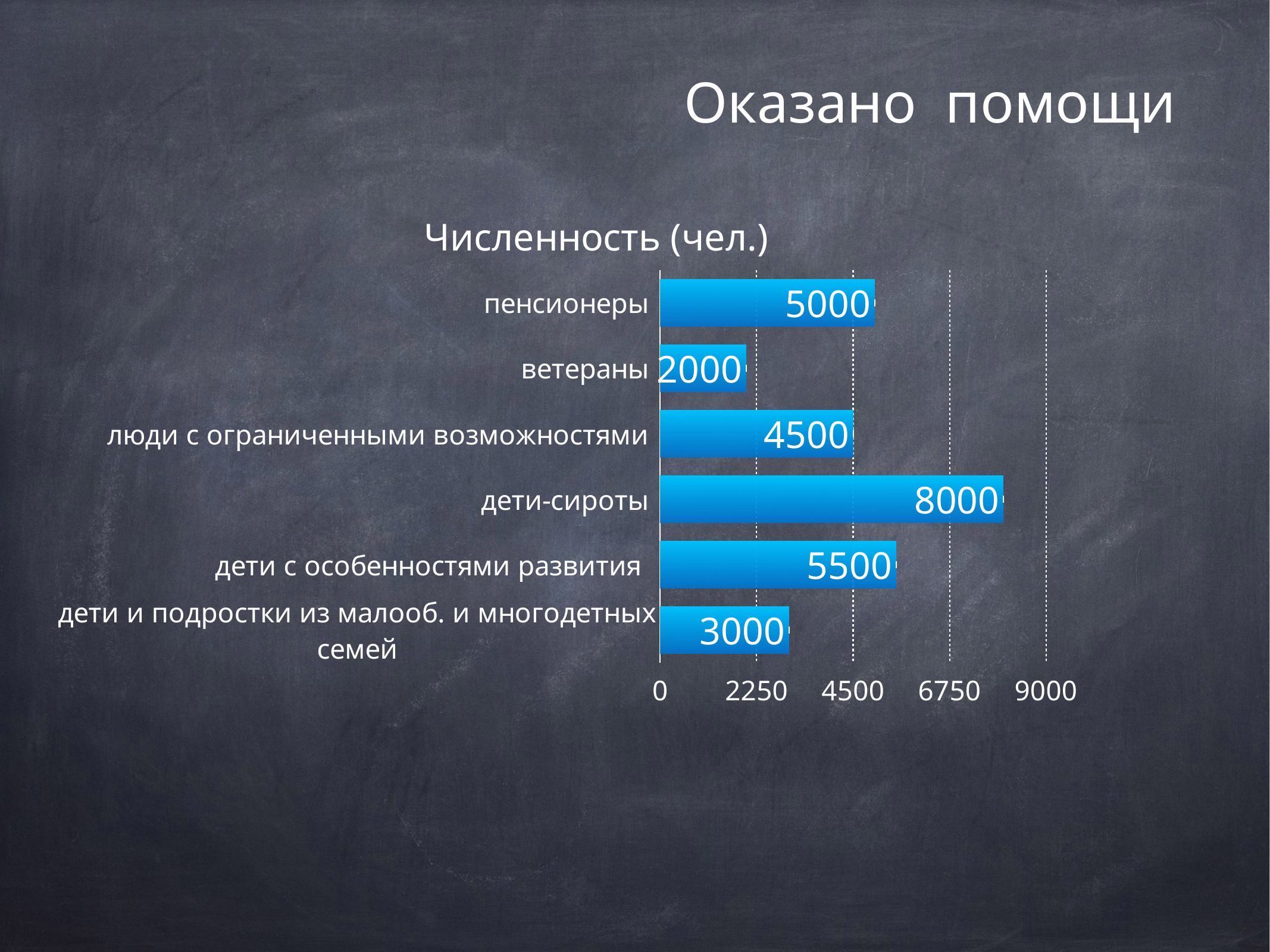
What is the value for дети-сироты? 8000 Is the value for дети и подростки из малооб. и многодетных семей greater or less than 4500? less What is the value for дети с особенностями развития? 5500 How many categories are shown in the chart? 6 Which is larger, the value for люди с ограниченными возможностями or the value for дети с особенностями развития? дети с особенностями развития What is the value for пенсионеры? 5000 What kind of chart is shown on the slide? bar chart What is the title of the chart? Численность (чел.) What is the value for ветераны? 2000 Which category has the highest value? дети-сироты What is the difference between the values for дети-сироты and пенсионеры? 3000 Which category has the lowest value? ветераны